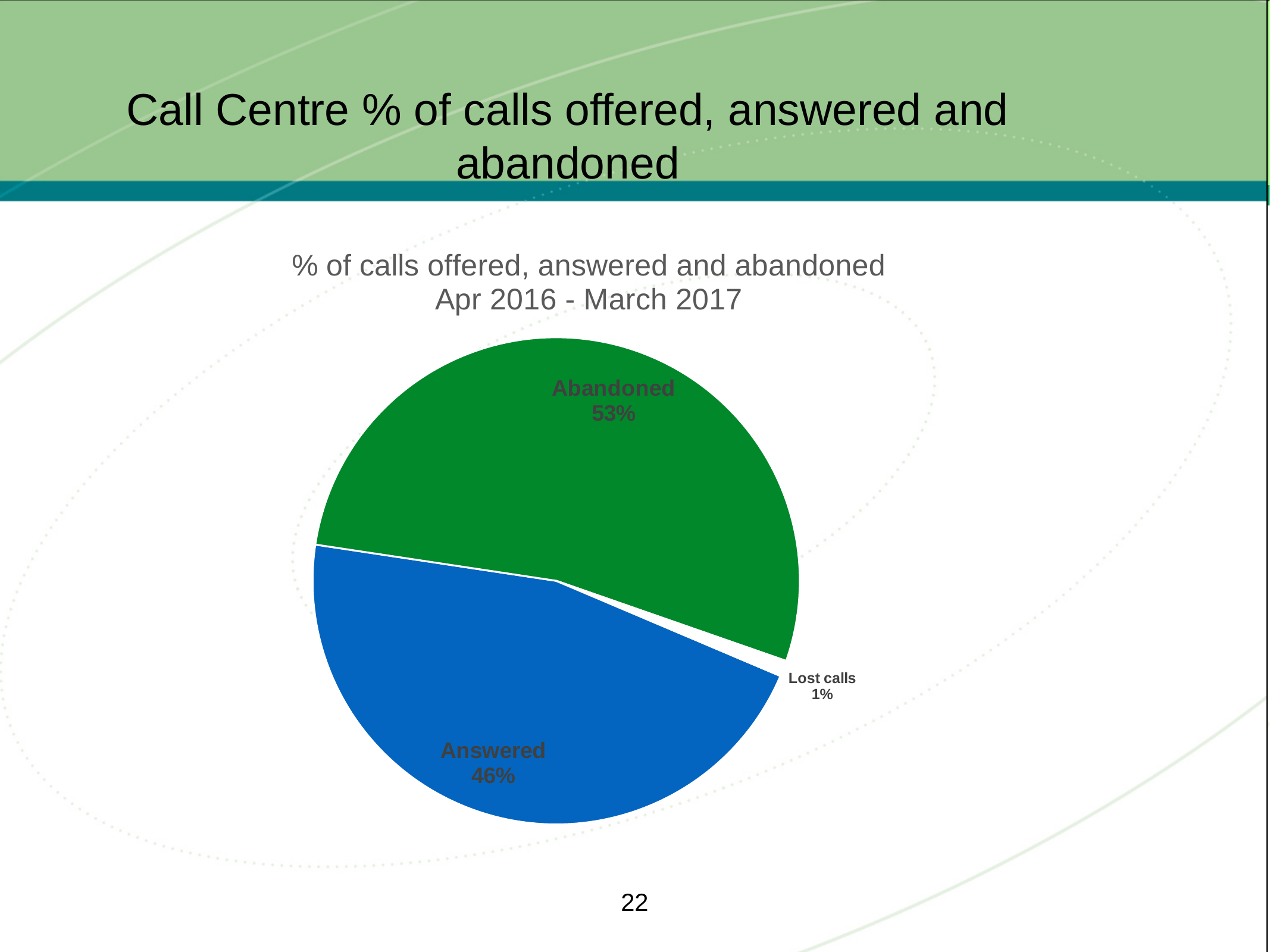
Which category has the largest share of the pie? Abandoned What is the difference in percentage points between Answered and Lost calls? 45 What percentage is shown for Lost calls? 1% What percentage of calls were Abandoned? 53% What colour is the Answered slice? blue How many slices does the pie chart have? 3 Which category has the smallest share of the pie? Lost calls Which is larger, the Answered share or the Abandoned share? Abandoned What is the difference in percentage points between Abandoned and Answered? 7 What percentage of calls were Answered? 46% What type of chart is shown on the slide? pie chart What is the chart's title? % of calls offered, answered and abandoned Apr 2016 - March 2017